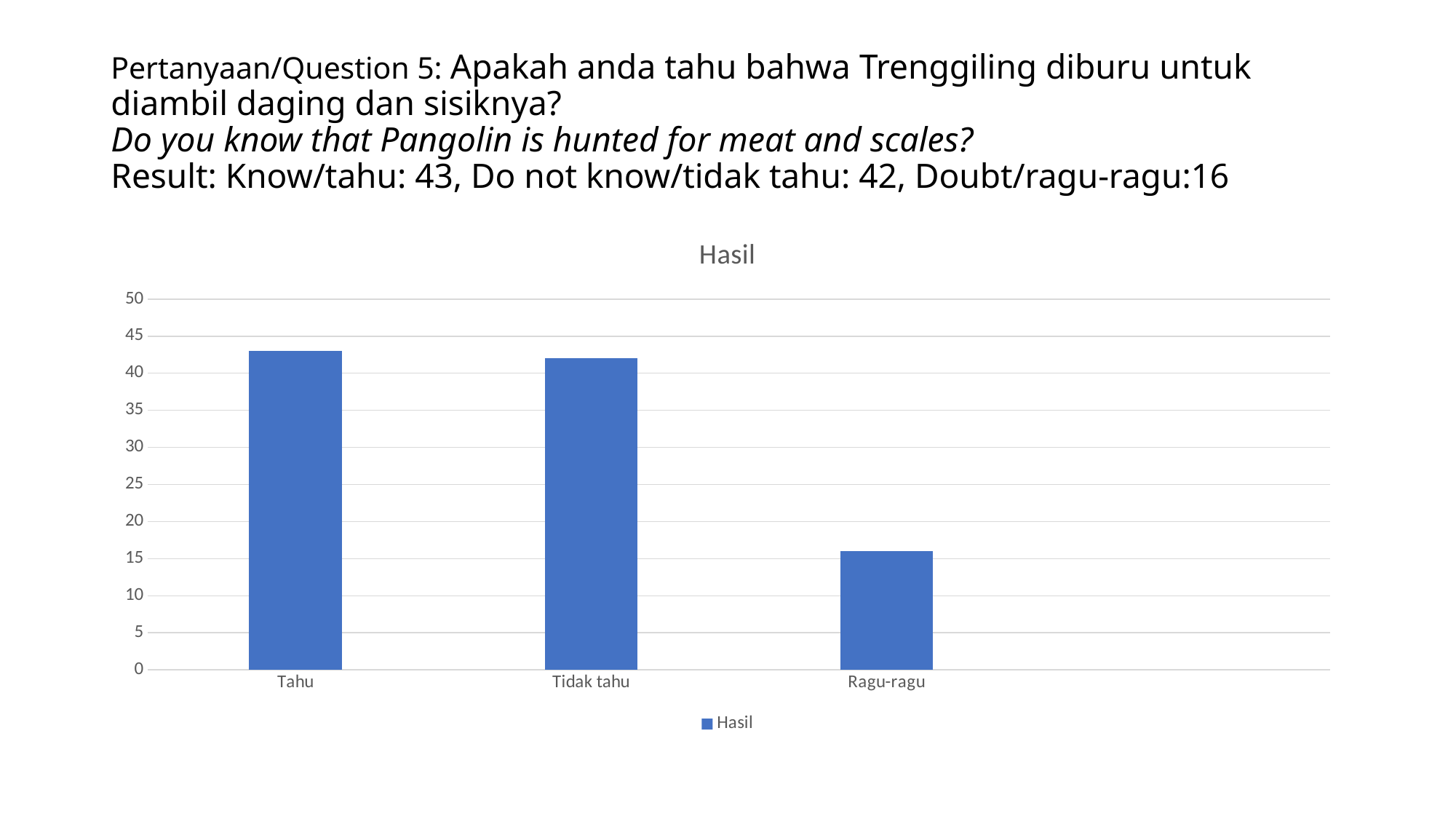
What is the difference between the values for Tahu and Ragu-ragu? 27 Which category has the lowest value in the Hasil chart? Ragu-ragu Which is larger, the value for Tidak tahu or the value for Ragu-ragu? Tidak tahu What is the value for Tidak tahu in the Hasil chart? 42 What kind of chart is shown on the slide? bar chart What is the value for Tahu in the Hasil chart? 43 What is the value for Ragu-ragu in the Hasil chart? 16 How many categories are shown on the x axis of the chart? 3 Which category has the highest value in the Hasil chart? Tahu How many series does the legend list? 1 What is the difference between the values for Tidak tahu and Ragu-ragu? 26 Is the value for Ragu-ragu greater or less than 20? less